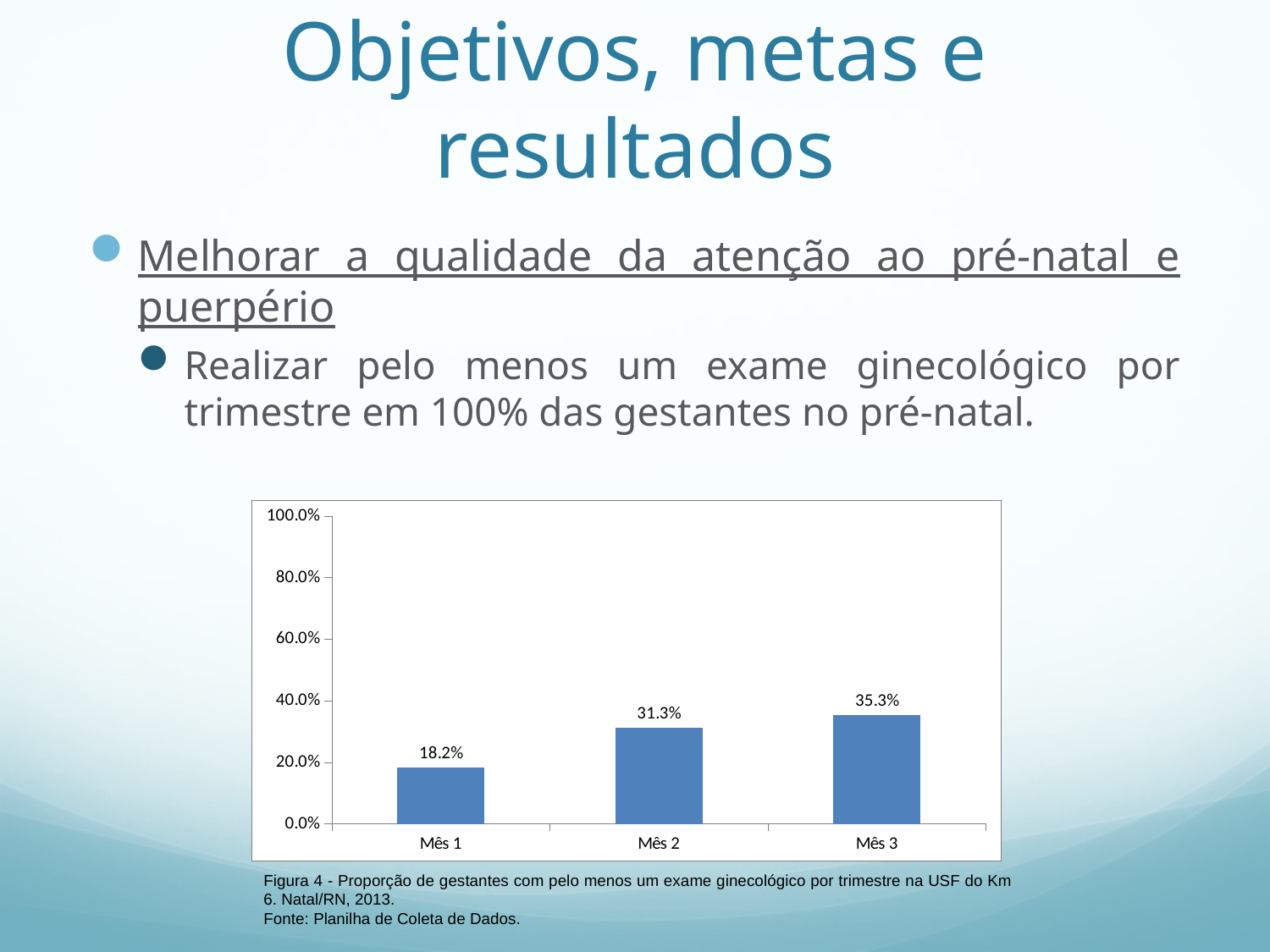
What is the value for Mês 3? 35.3% What is the value for Mês 1? 18.2% Which month has the lowest value? Mês 1 What is the value for Mês 2? 31.3% Which month has the highest value? Mês 3 Do the values rise or fall from Mês 1 to Mês 3? rise What kind of chart is shown on the slide? bar chart What is the difference between the values for Mês 3 and Mês 1? 17.1% What is the difference between the values for Mês 2 and Mês 1? 13.1% Which is larger, the value for Mês 2 or the value for Mês 3? Mês 3 Is the value for Mês 1 greater or less than 20.0%? less How many months are shown on the x axis? 3